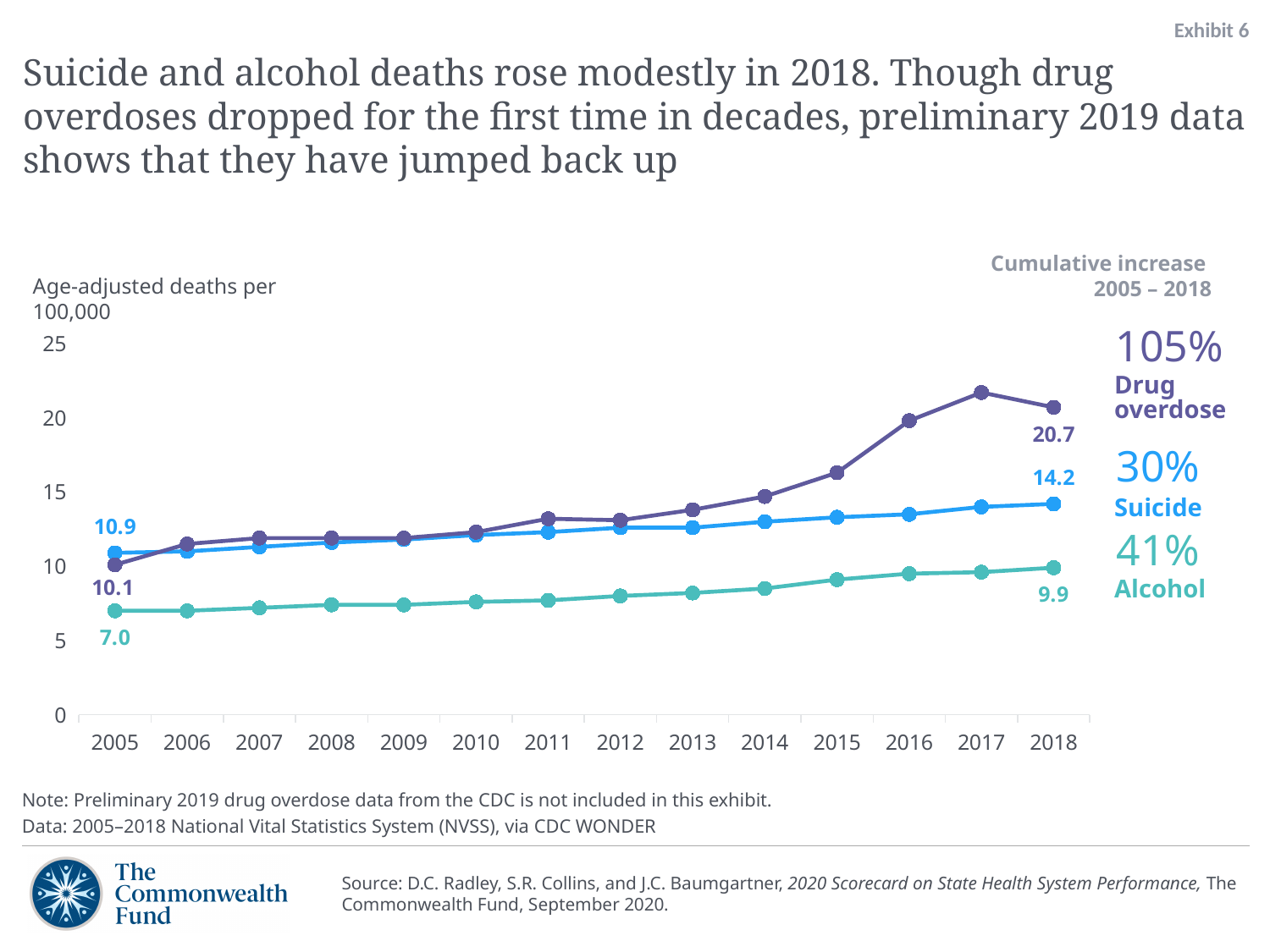
Which series had the lowest value in 2005? Alcohol What type of chart is shown on the slide? line chart What was the suicide death rate in 2005? 10.9 What was the drug overdose death rate in 2005? 10.1 Is the drug overdose death rate in 2017 greater or less than 20? greater Which series had the highest value in 2018? Drug overdose What is the cumulative increase for suicide deaths from 2005 to 2018? 30% What was the alcohol death rate in 2018? 9.9 By how much did the drug overdose death rate increase from 2005 to 2018? 10.6 How many series are plotted on the chart? 3 How many years are shown on the x axis? 14 What was the drug overdose death rate in 2018? 20.7